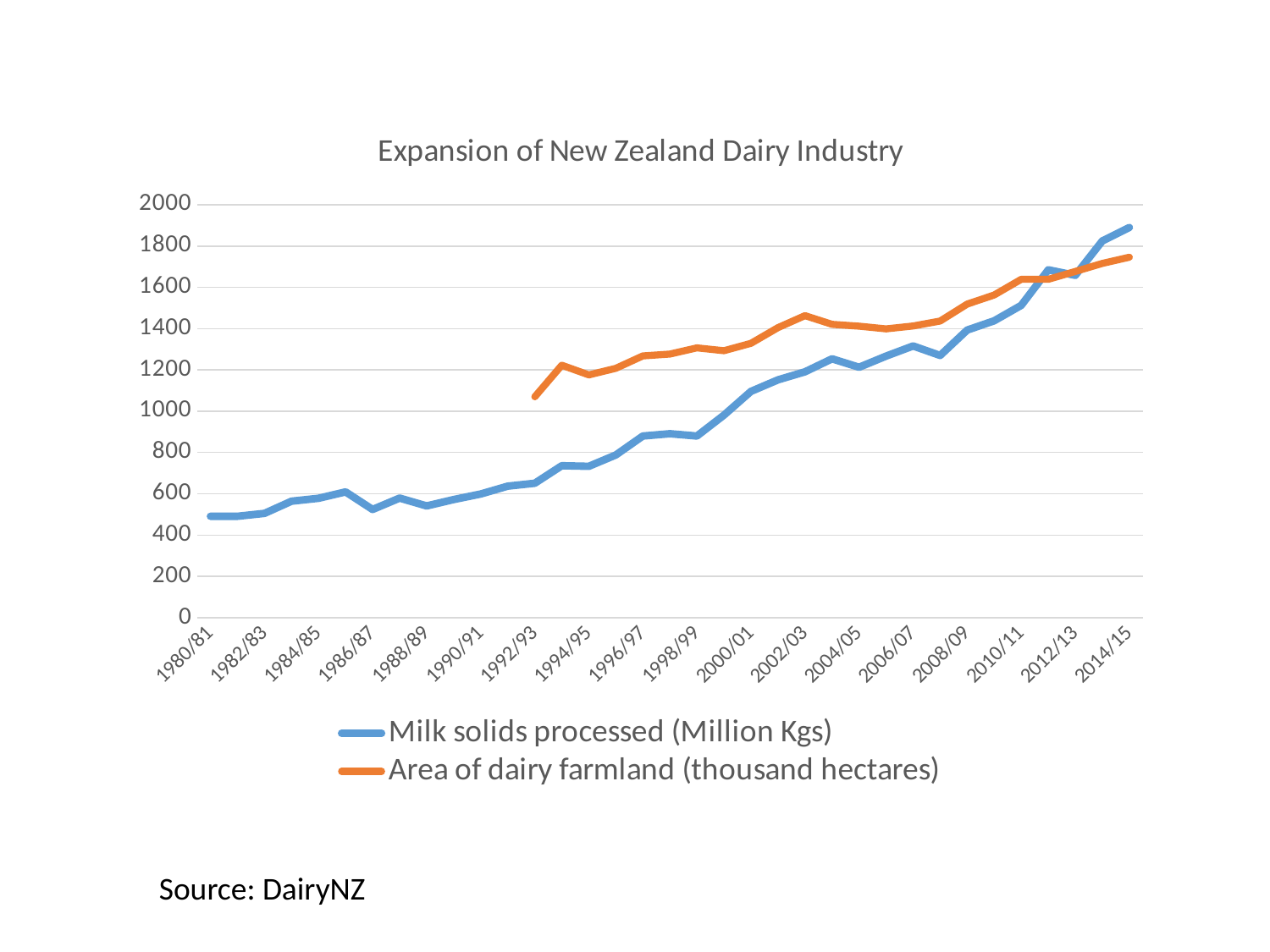
Which colour is used for the Milk solids processed (Million Kgs) line? blue What is the title of the chart? Expansion of New Zealand Dairy Industry Is the value for Area of dairy farmland in 2014/15 greater or less than 1800? less Is the value for Milk solids processed in 2014/15 greater or less than 1800? greater In 2014/15, which series has the larger value: Milk solids processed or Area of dairy farmland? Milk solids processed In 2000/01, which series has the larger value: Milk solids processed or Area of dairy farmland? Area of dairy farmland Is the value for Milk solids processed in 1980/81 greater or less than 600? less In which year does the Milk solids processed series reach its highest value? 2014/15 What kind of chart is shown on the slide? line chart How many series does the legend list? 2 Overall, do the values for Milk solids processed rise or fall from 1980/81 to 2014/15? rise